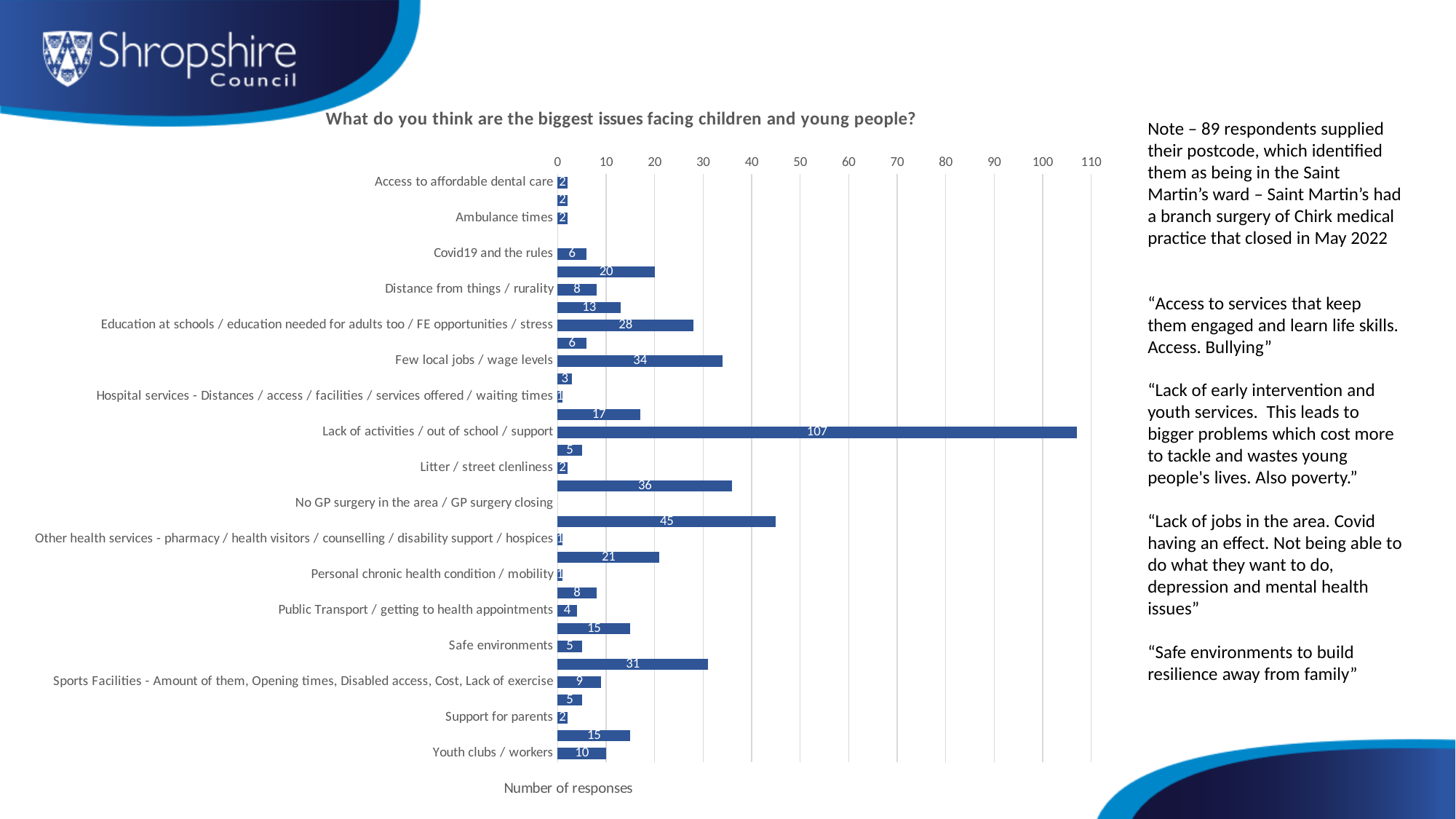
Is the value for 'Lack of activities / out of school / support' greater or less than 100? greater What is the title of the chart? What do you think are the biggest issues facing children and young people? How many responses are shown for 'Youth clubs / workers'? 10 Which category has the highest number of responses? Lack of activities / out of school / support How many responses are shown for 'Sports Facilities - Amount of them, Opening times, Disabled access, Cost, Lack of exercise'? 9 What kind of chart is shown on the slide? bar chart What is the label on the value axis of the chart? Number of responses How many responses are shown for 'Few local jobs / wage levels'? 34 Which has more responses: 'Few local jobs / wage levels' or 'Education at schools / education needed for adults too / FE opportunities / stress'? Few local jobs / wage levels How many responses are shown for 'Education at schools / education needed for adults too / FE opportunities / stress'? 28 What is the difference in responses between 'Lack of activities / out of school / support' and 'Few local jobs / wage levels'? 73 How many responses are shown for 'Lack of activities / out of school / support'? 107